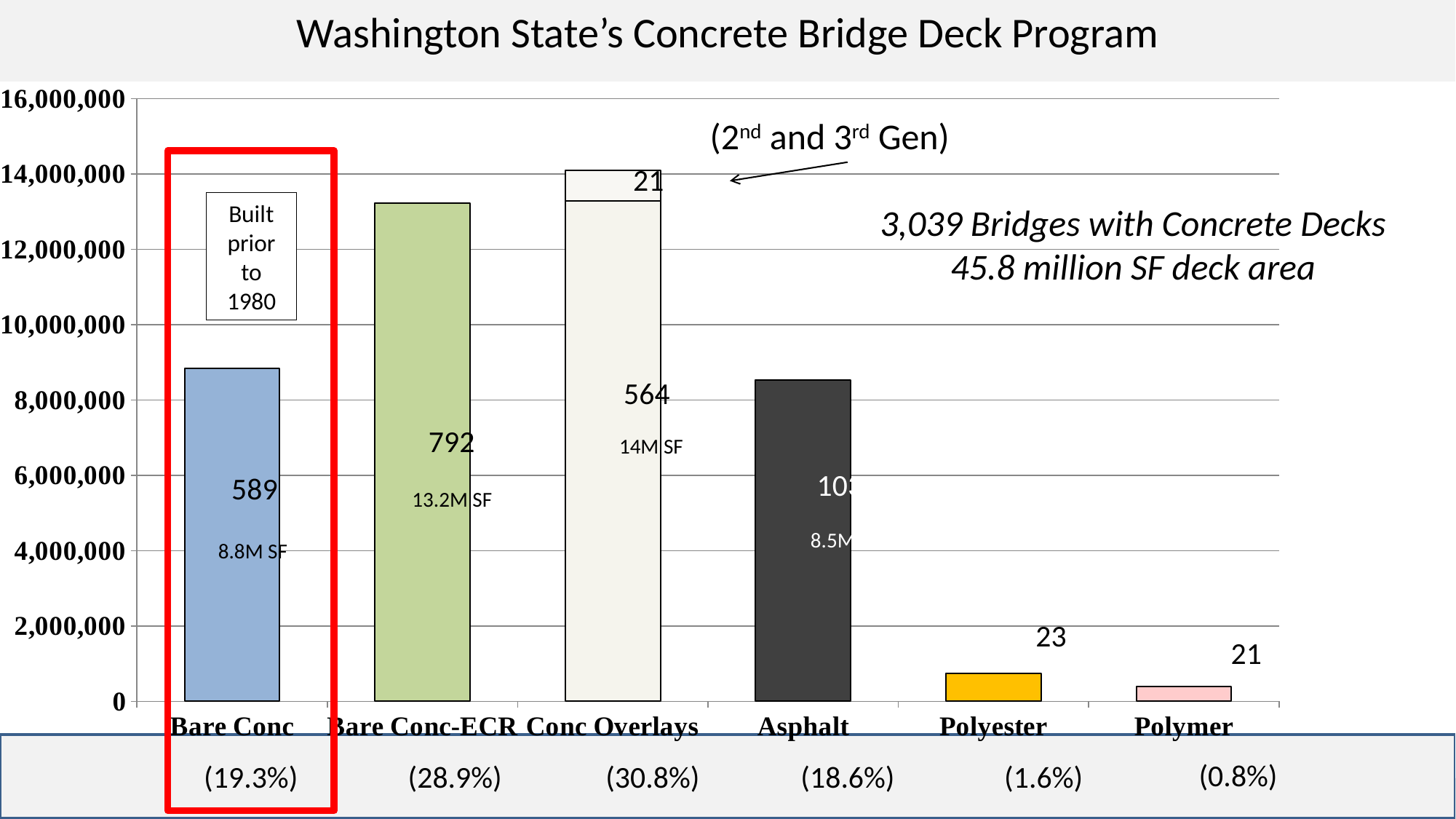
Is the value for Polyester greater or less than 2,000,000? less What percentage is shown below the Conc Overlays category? 30.8% What number is printed on the Bare Conc-ECR bar? 792 How many deck categories are shown along the x axis of the chart? 6 Which deck category has the tallest bar in the chart? Conc Overlays Is the value for Bare Conc-ECR greater or less than 12,000,000? greater What is the difference between the numbers printed on the Bare Conc-ECR bar (792) and the Bare Conc bar (589)? 203 What number is printed above the Polyester bar? 23 What deck area label is printed on the Bare Conc-ECR bar? 13.2M SF Which deck category has the shortest bar in the chart? Polymer What kind of chart is shown on the slide? bar chart What number is printed on the Bare Conc bar? 589